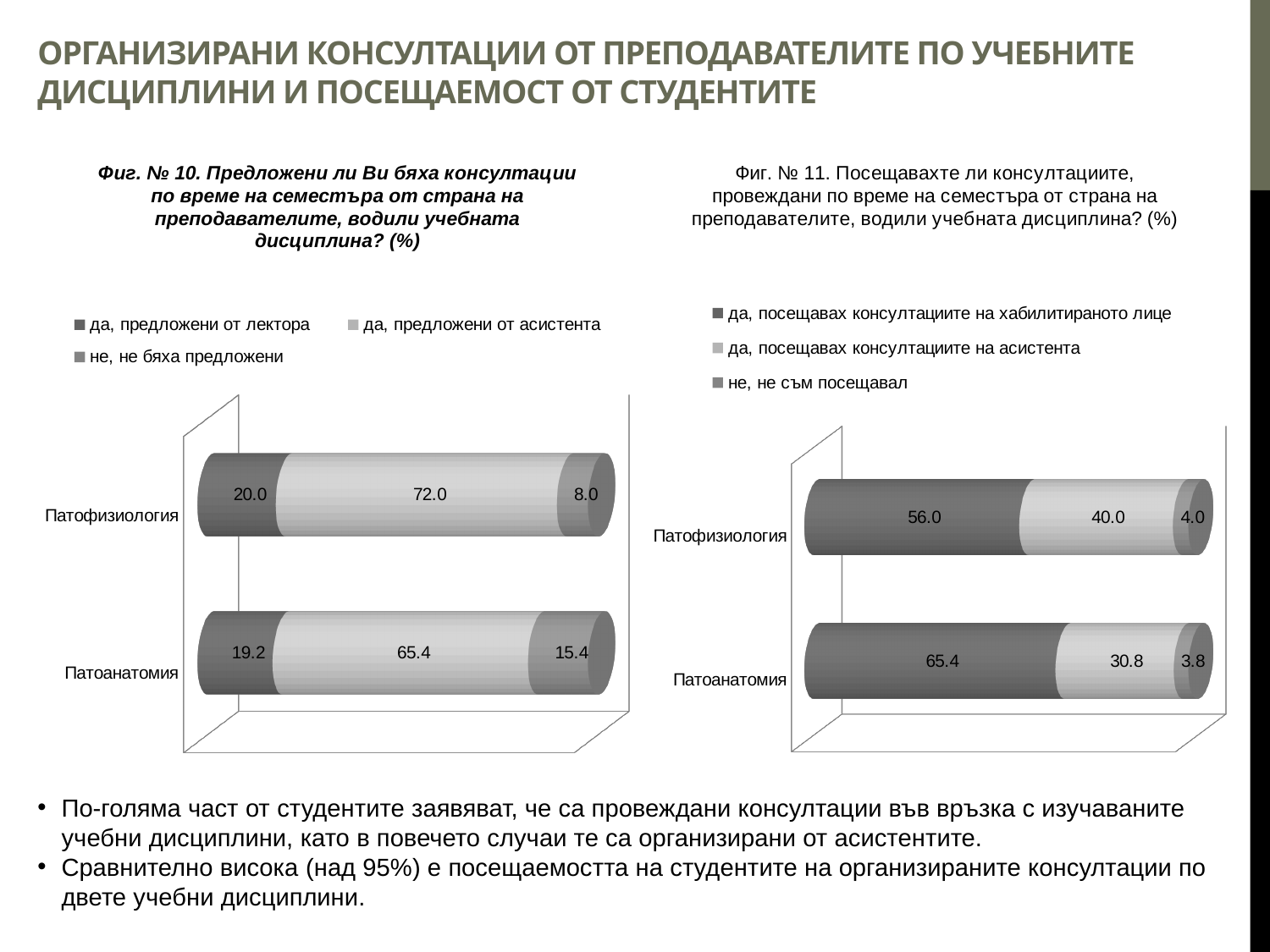
How many series does the legend of the chart Фиг. № 10 (left) list? 3 What kind of chart is Фиг. № 10 (left)? Stacked bar chart In the chart Фиг. № 10 (left), what is the value for 'не, не бяха предложени' for Патоанатомия? 15.4 In the chart Фиг. № 11 (right), what is the value for 'не, не съм посещавал' for Патофизиология? 4.0 In the chart Фиг. № 11 (right), which category has the larger value for 'да, посещавах консултациите на асистента', Патофизиология or Патоанатомия? Патофизиология In the chart Фиг. № 11 (right), what is the value for 'да, посещавах консултациите на хабилитираното лице' for Патоанатомия? 65.4 In the chart Фиг. № 10 (left), what is the value for 'да, предложени от асистента' for Патофизиология? 72.0 In the chart Фиг. № 10 (left), what is the difference between the 'да, предложени от асистента' values for Патофизиология and Патоанатомия? 6.6 In the chart Фиг. № 11 (right), which series has the lowest value for Патофизиология? не, не съм посещавал In the chart Фиг. № 11 (right), what is the total of the stacked bar for Патоанатомия? 100.0 How many categories are shown in the chart Фиг. № 11 (right)? 2 In the chart Фиг. № 10 (left), which series has the highest value for Патоанатомия? да, предложени от асистента